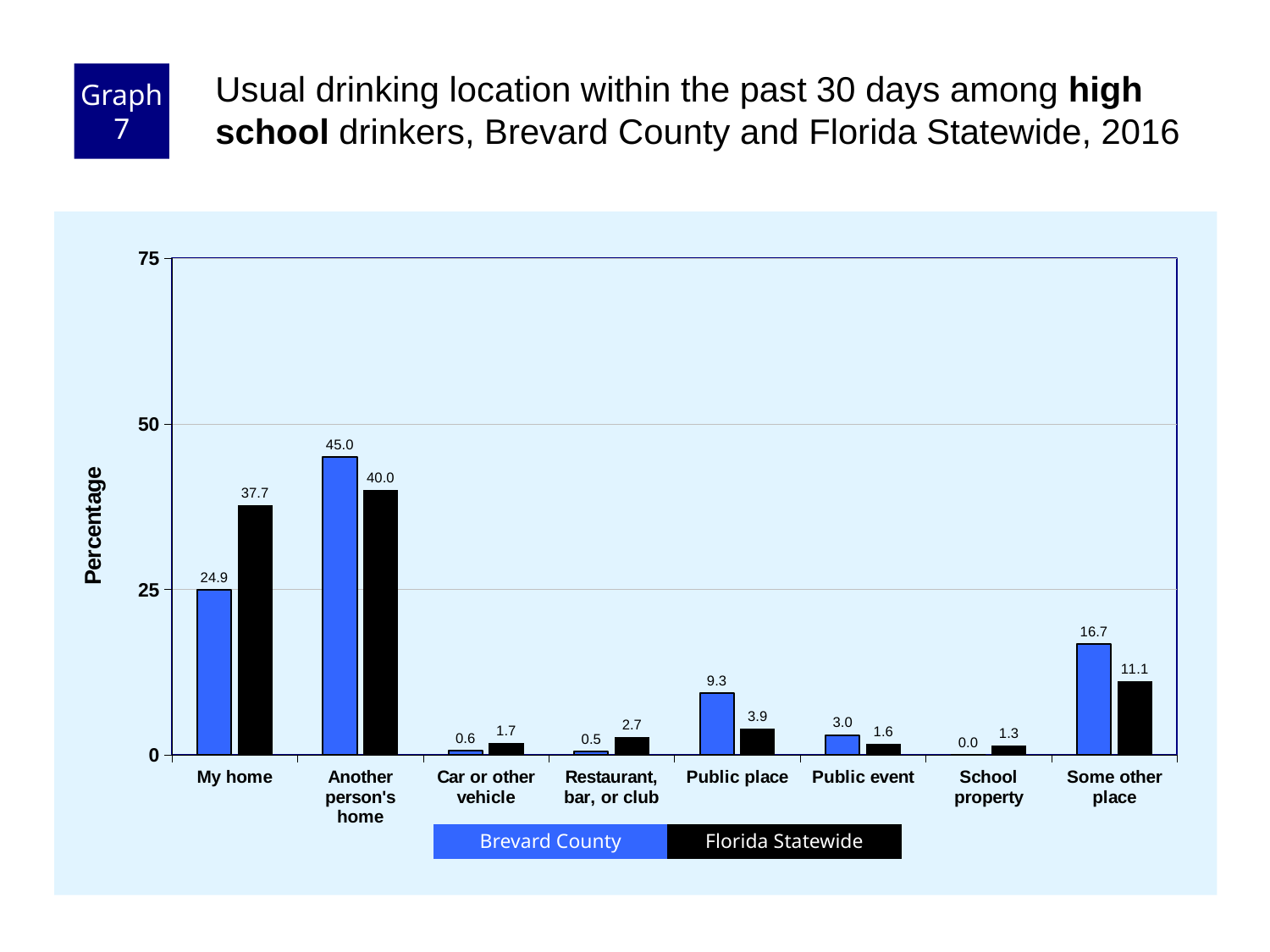
What kind of chart is shown on the slide? Bar chart What is the Brevard County value for "My home"? 24.9 How many series does the legend list? 2 Which is larger for "Some other place": Brevard County or Florida Statewide? Brevard County What is the difference between the Florida Statewide and Brevard County values for "My home"? 12.8 Which category has the highest Brevard County value? Another person's home Is the Brevard County value for "Another person's home" greater or less than 50? less What is the Florida Statewide value for "Another person's home"? 40.0 Which category has the lowest Brevard County value? School property What is the label of the y axis? Percentage How many categories are shown on the x axis? 8 What is the Brevard County value for "Public place"? 9.3